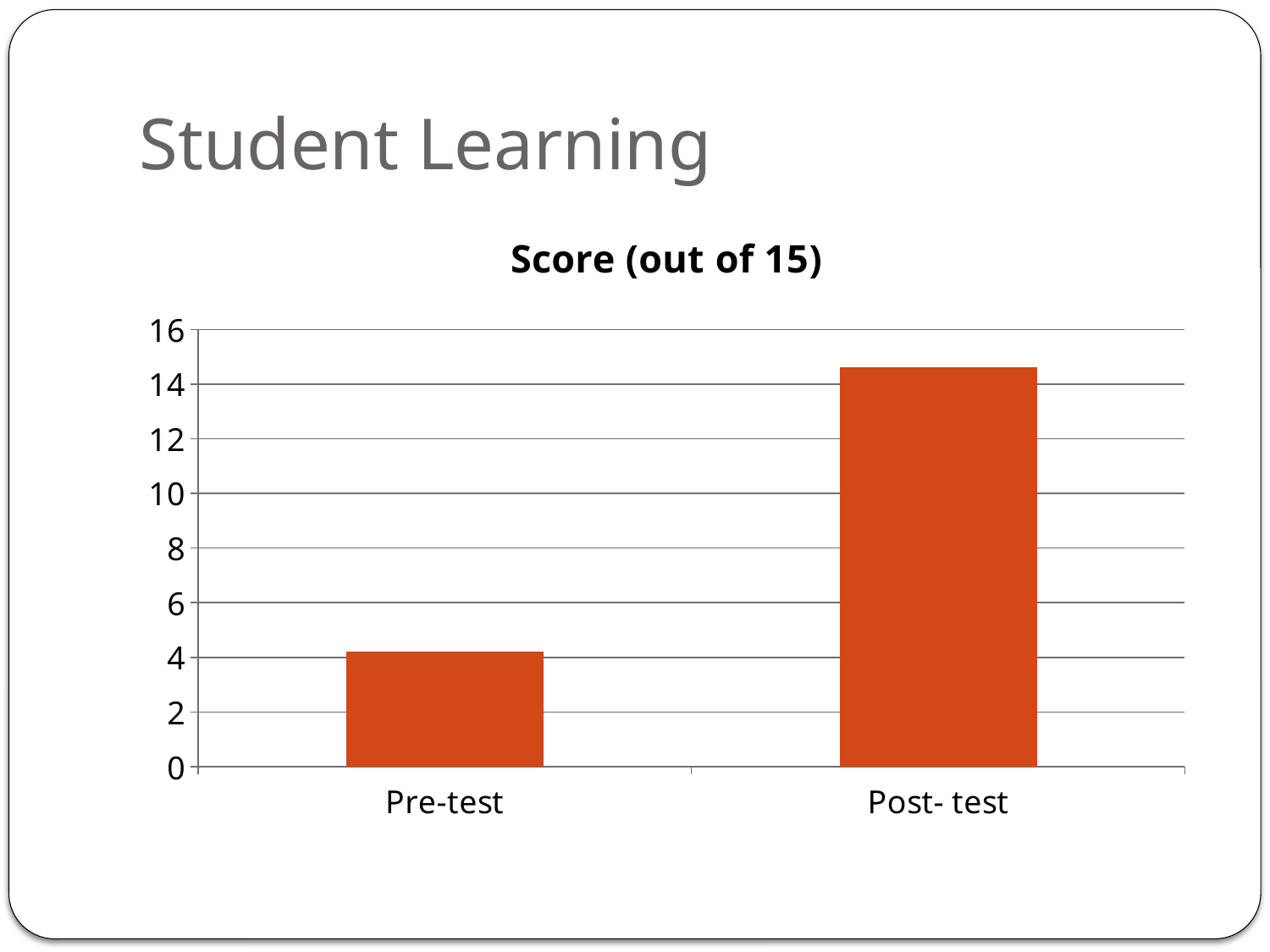
Do the values rise or fall from Pre-test to Post- test? rise What is the highest value shown on the y axis of the chart? 16 What is the title of the chart? Score (out of 15) What kind of chart is shown on the slide? bar chart How many categories are shown on the x axis of the chart? 2 Which category has the lowest score? Pre-test Is the value for Post- test greater or less than 16? less Which category has the highest score? Post- test Is the value for Pre-test greater or less than 2? greater Is the value for Post- test greater or less than 14? greater Which is larger, the Pre-test score or the Post- test score? Post- test